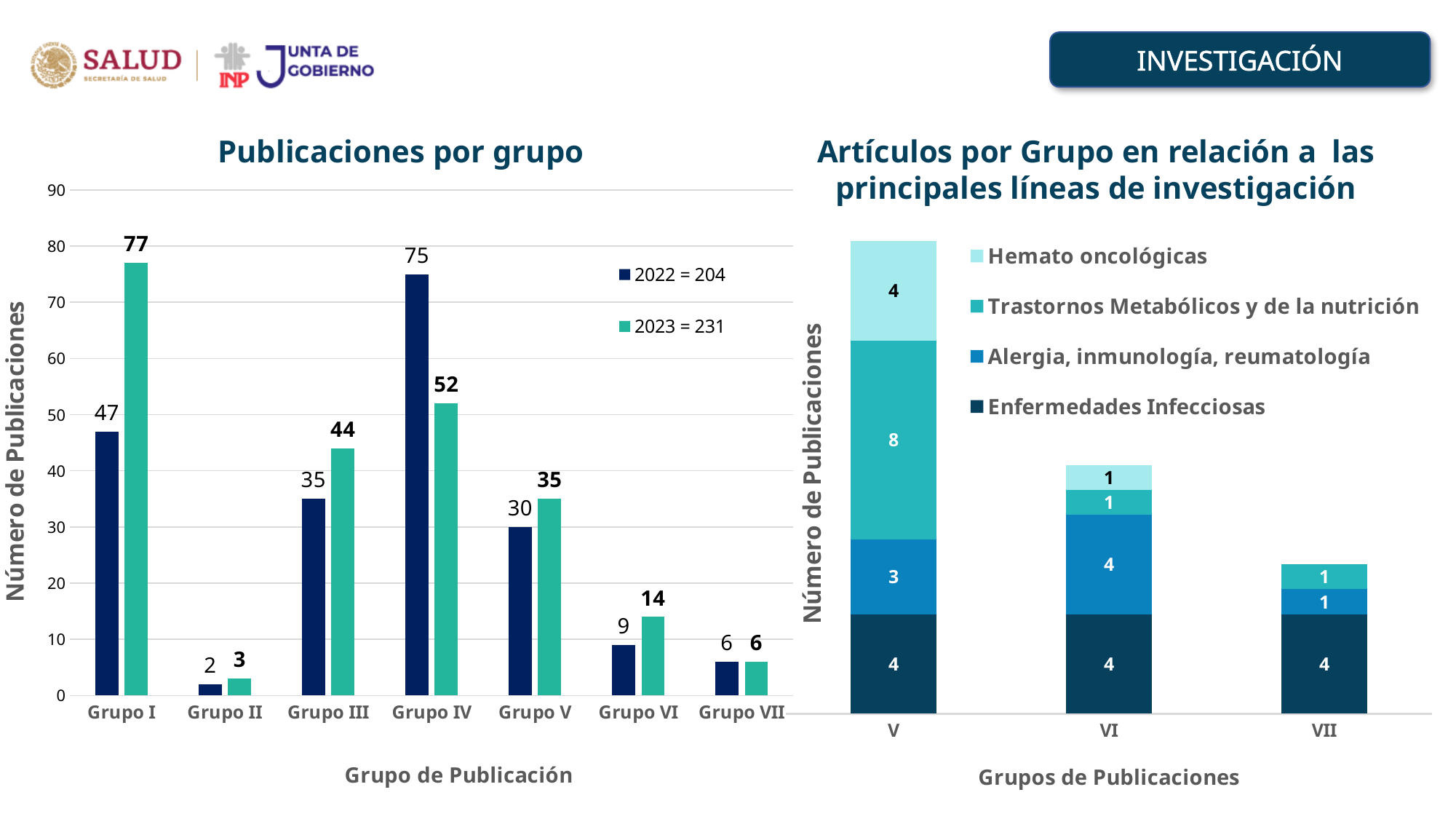
In the 'Artículos por Grupo' chart on the right, what is the total of the stacked bar for group VI? 10 In the 'Publicaciones por grupo' chart, how many series does the legend list? 2 In the 'Publicaciones por grupo' chart, which group has the highest 2023 value? Grupo I In the 'Publicaciones por grupo' chart, which is larger for Grupo III: the 2022 value or the 2023 value? 2023 In the 'Publicaciones por grupo' chart, what is the 2022 value for Grupo IV? 75 In the 'Artículos por Grupo' chart on the right, what is the value of 'Trastornos Metabólicos y de la nutrición' for group V? 8 In the 'Publicaciones por grupo' chart, which group has the lowest 2022 value? Grupo II In the 'Publicaciones por grupo' chart, what is the difference between the 2022 and 2023 values for Grupo IV? 23 In the 'Publicaciones por grupo' chart, what is the 2023 value for Grupo I? 77 In the 'Artículos por Grupo' chart on the right, how many series does the legend list? 4 In the 'Publicaciones por grupo' chart, how many groups are shown on the x axis? 7 What kind of chart is the 'Artículos por Grupo en relación a las principales líneas de investigación' chart? Stacked bar chart